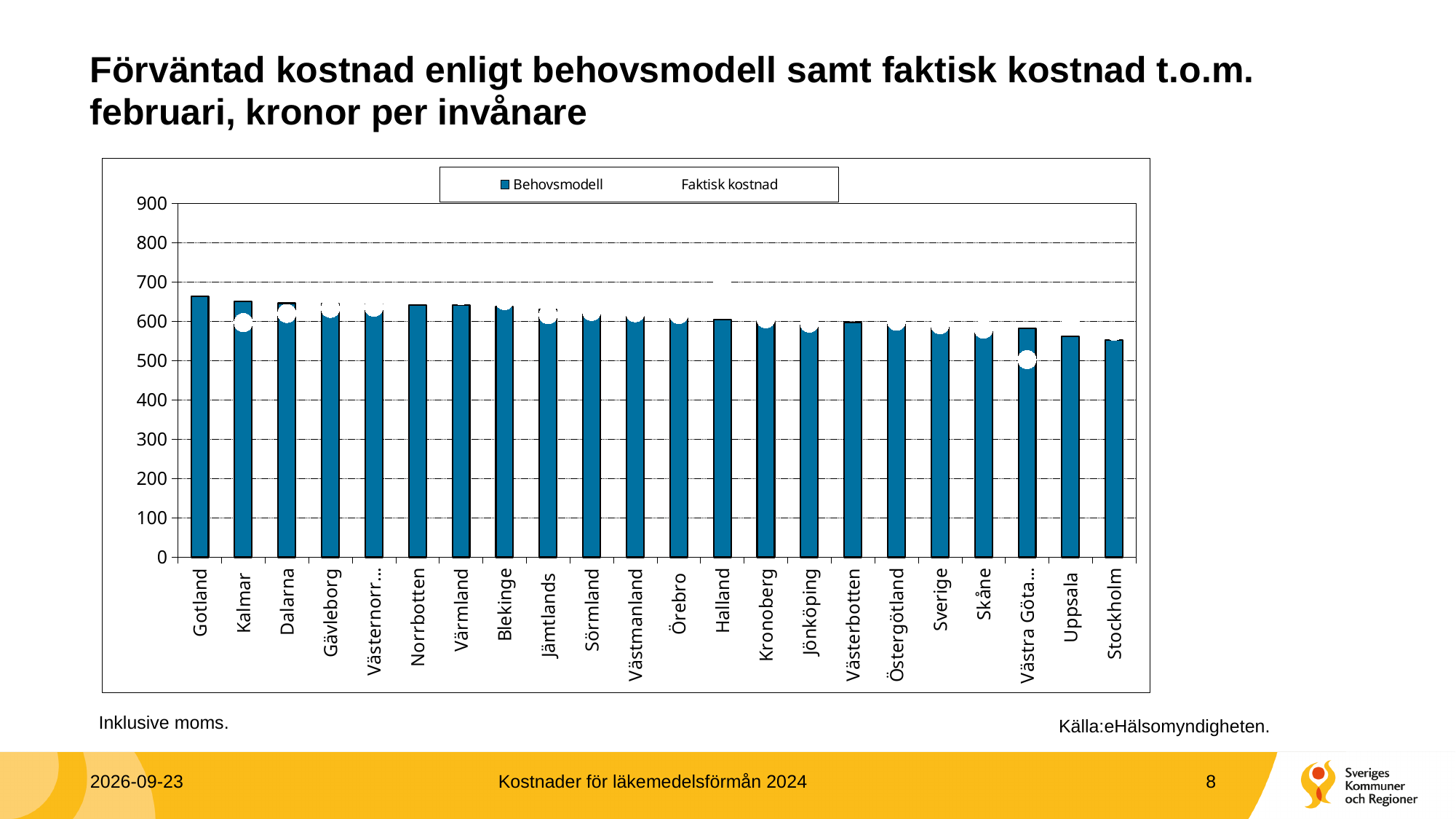
Is the Behovsmodell value for Uppsala greater or less than 600? less Which has the larger Behovsmodell value, Kalmar or Uppsala? Kalmar What are the two series named in the legend? Behovsmodell and Faktisk kostnad How many series does the legend list? 2 Is the Behovsmodell value for Gotland greater or less than 600? greater What kind of chart is shown on the slide? bar chart Do the Behovsmodell values generally rise or fall from left to right along the x axis? fall Which category has the lowest Behovsmodell bar? Stockholm Is the Behovsmodell value for Stockholm greater or less than 600? less Which category has the highest Behovsmodell bar? Gotland How many categories are shown on the x axis? 22